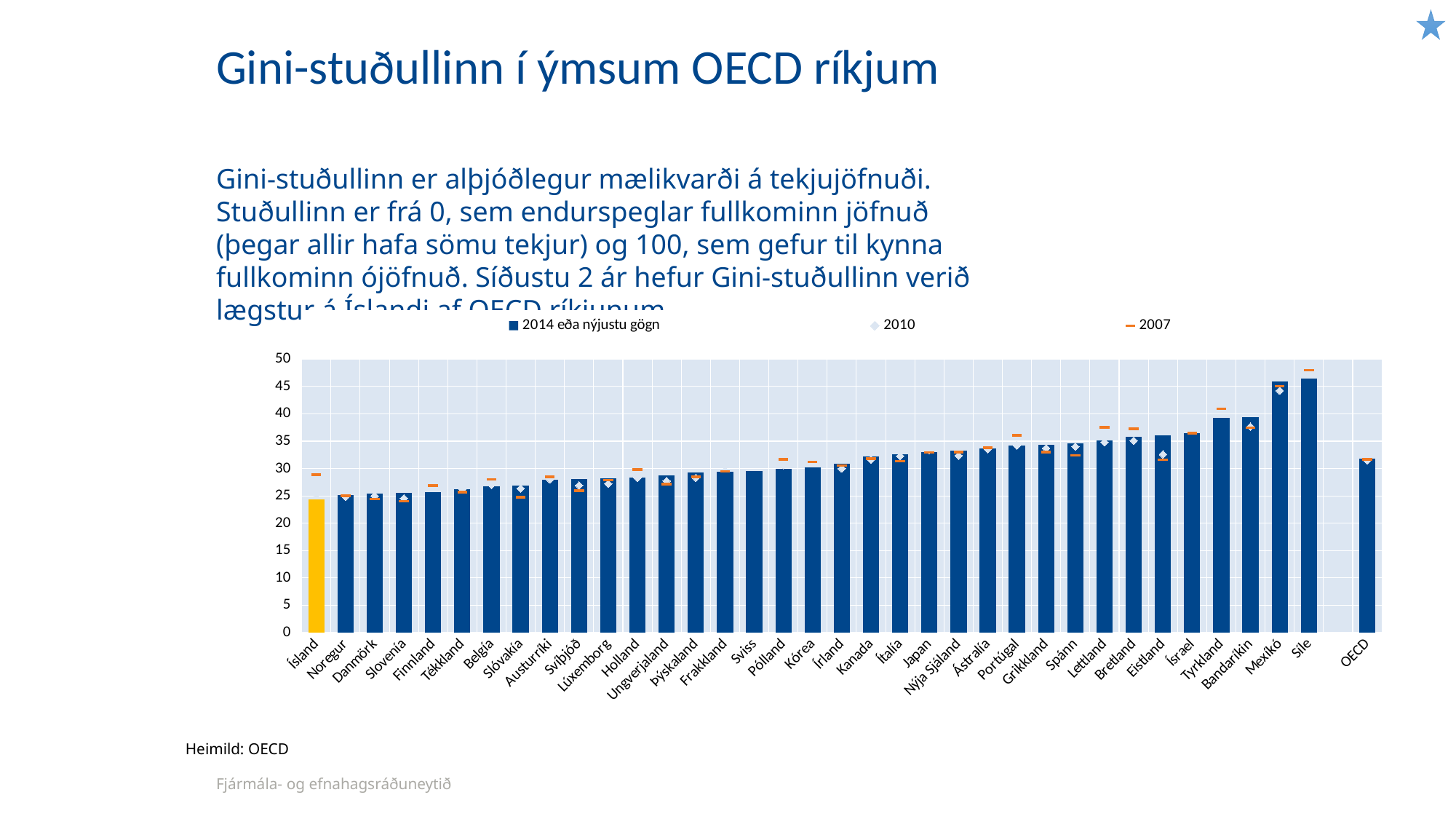
Which has a larger 2014 bar, Tyrkland or Noregur? Tyrkland Which category has the lowest 2014 bar in the chart? Ísland Is the 2014 value for OECD greater or less than 30? greater Which category has the highest 2014 bar in the chart? Síle Is the 2014 value for Síle greater or less than 45? greater Which category's bar is coloured differently (yellow) from the other bars? Ísland How many series does the chart legend list? 3 Do the 2014 bars generally rise or fall from Ísland to Síle along the x axis? rise Is the 2014 value for Ísland greater or less than 25? less How many categories are shown on the x axis of the chart? 36 What kind of chart is shown on the slide? Bar chart